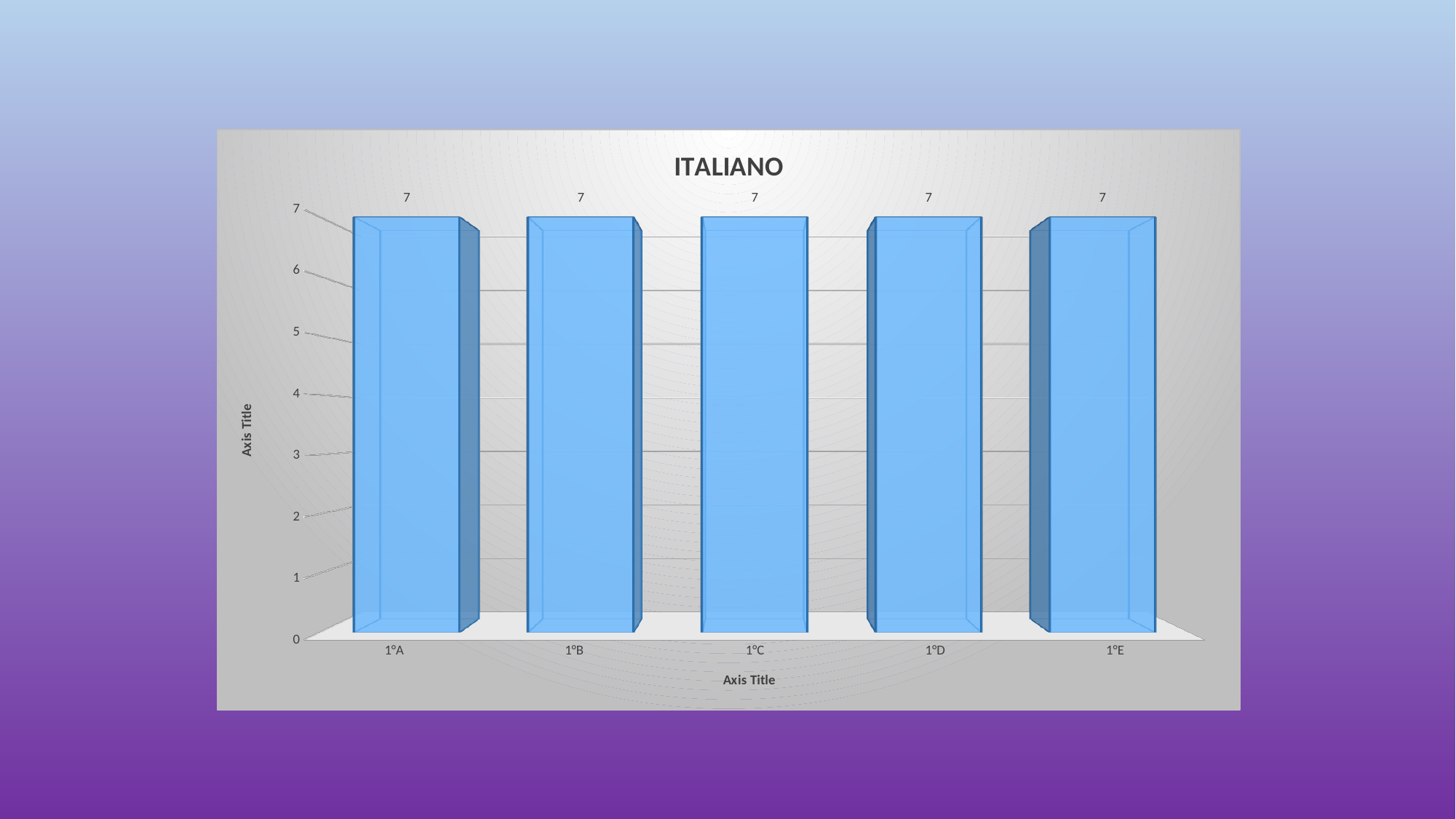
What kind of chart is shown on the slide? Bar chart What colour are the bars in the chart? Blue Is the value for 1°B greater or less than 5? greater What is the difference between the values for 1°B and 1°D? 0 What is the title of the chart? ITALIANO Is the value for 1°A larger than, smaller than, or equal to the value for 1°E? Equal How many categories are shown on the x axis? 5 What is the value for 1°A? 7 What is the value for 1°C? 7 Do the values rise, fall, or stay the same from 1°A to 1°E? Stay the same What is the value for 1°D? 7 What is the value for 1°E? 7